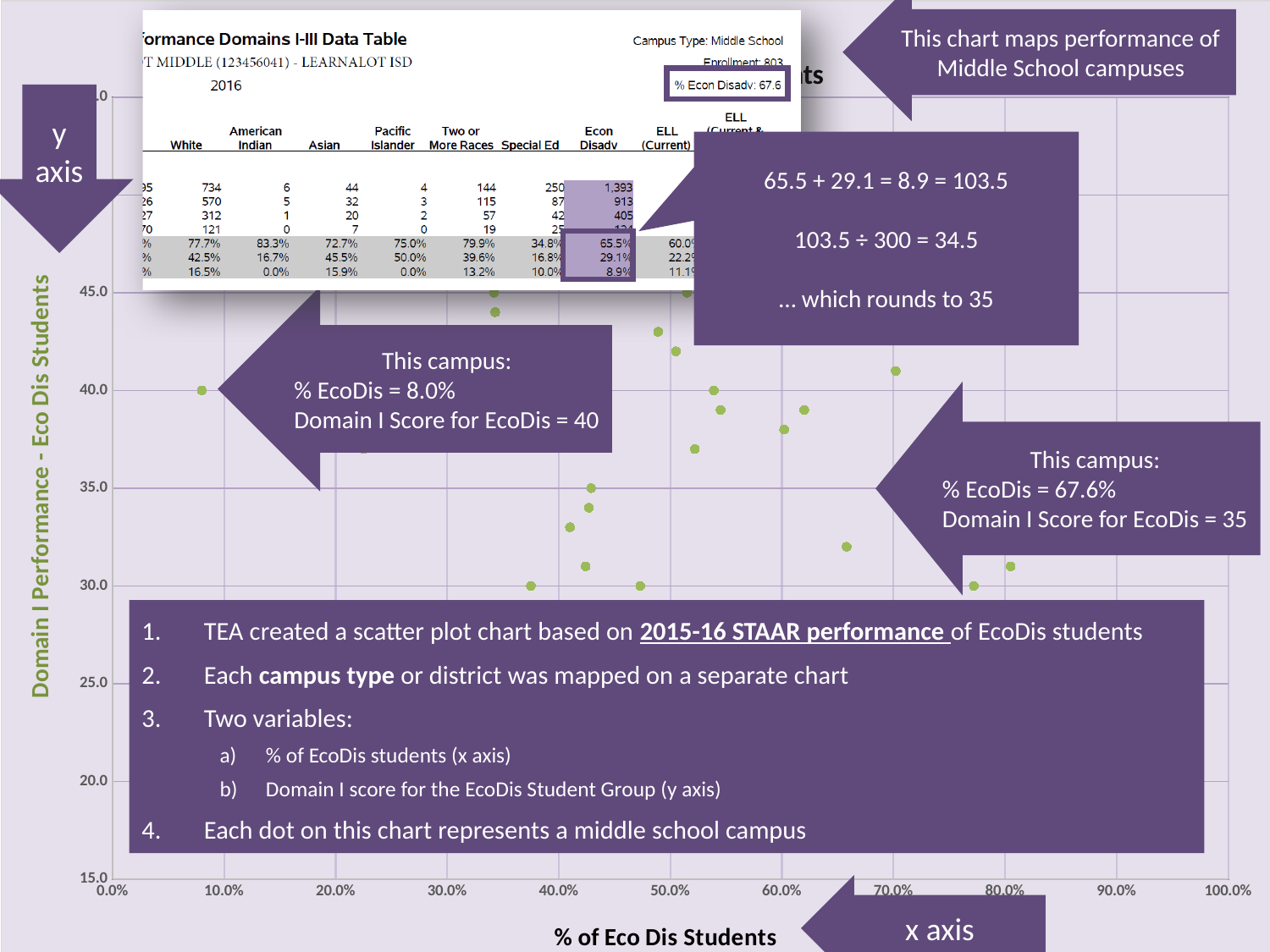
What is the difference in % EcoDis between the two labelled campuses (67.6% and 8.0%)? 59.6% What is the title of the x axis of the scatter plot? % of Eco Dis Students According to the slide, what does each dot on the chart represent? a middle school campus What is the Domain I Score for EcoDis for the campus with % EcoDis = 67.6%? 35 Which labelled campus has the higher % EcoDis: the one with a Domain I Score of 40 or the one with a Domain I Score of 35? the one with a Domain I Score of 35 What kind of chart is shown on the slide? scatter plot What is the difference in Domain I Score between the campus with 8.0% EcoDis and the campus with 67.6% EcoDis? 5 What is the Domain I Score for EcoDis for the campus with % EcoDis = 8.0%? 40 Which labelled campus has the higher Domain I Score for EcoDis: the one with 8.0% EcoDis or the one with 67.6% EcoDis? the one with 8.0% EcoDis